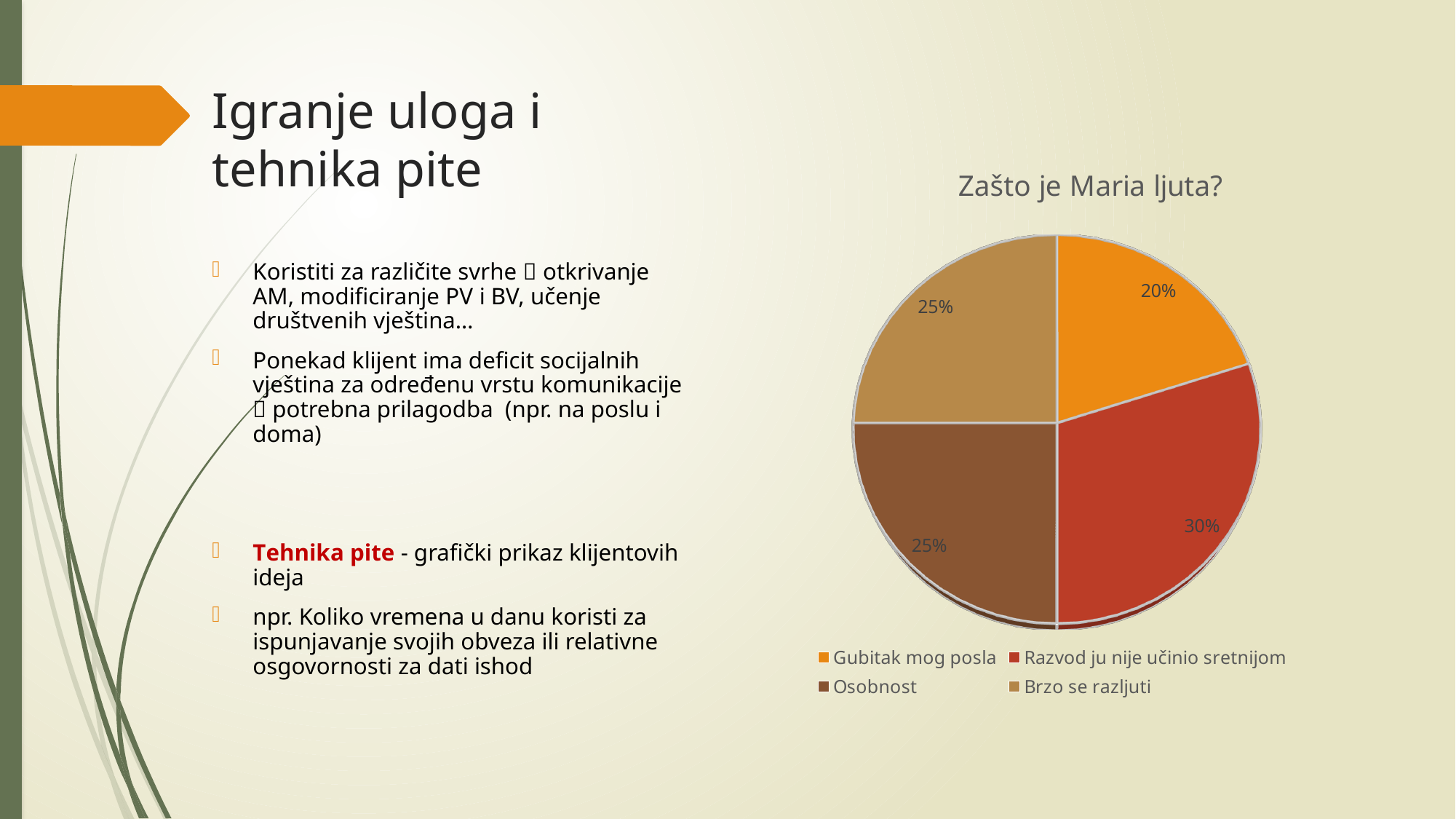
What colour is the slice for "Gubitak mog posla"? Orange How many categories does the legend list? 4 What type of chart is shown on the slide? Pie chart Which is larger: the slice for "Osobnost" or the slice for "Gubitak mog posla"? Osobnost Which category has the largest slice of the pie? Razvod ju nije učinio sretnijom What percentage is shown for "Gubitak mog posla"? 20% What is the difference in percentage points between "Razvod ju nije učinio sretnijom" and "Gubitak mog posla"? 10 What percentage is shown for "Razvod ju nije učinio sretnijom"? 30% What is the title of the chart? Zašto je Maria ljuta? Which category has the smallest slice of the pie? Gubitak mog posla What percentage is shown for "Osobnost"? 25% What percentage is shown for "Brzo se razljuti"? 25%